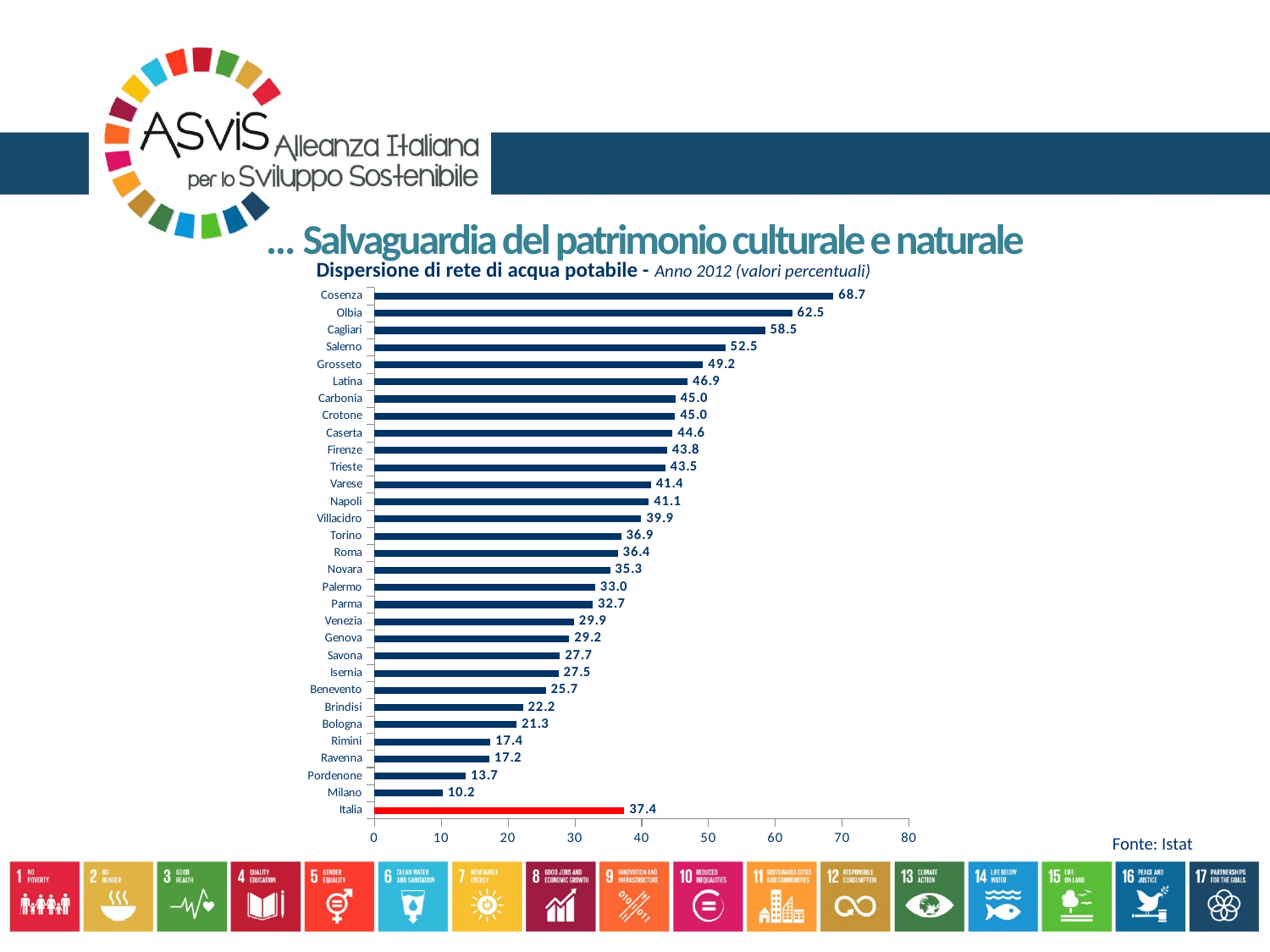
What is the value for Milano? 10.2 What kind of chart is shown? bar chart What is the difference between the values for Olbia and Cagliari? 4.0 How many categories are plotted on the chart? 31 What is the value for Italia? 37.4 What is the difference between the value for Italia and the value for Milano? 27.2 Which bar is coloured red instead of dark blue? Italia Is the value for Salerno greater or less than 50? greater Which is larger, the value for Roma or the value for Torino? Torino Which city has the highest value? Cosenza What is the value for Cosenza? 68.7 Which city has the lowest value? Milano